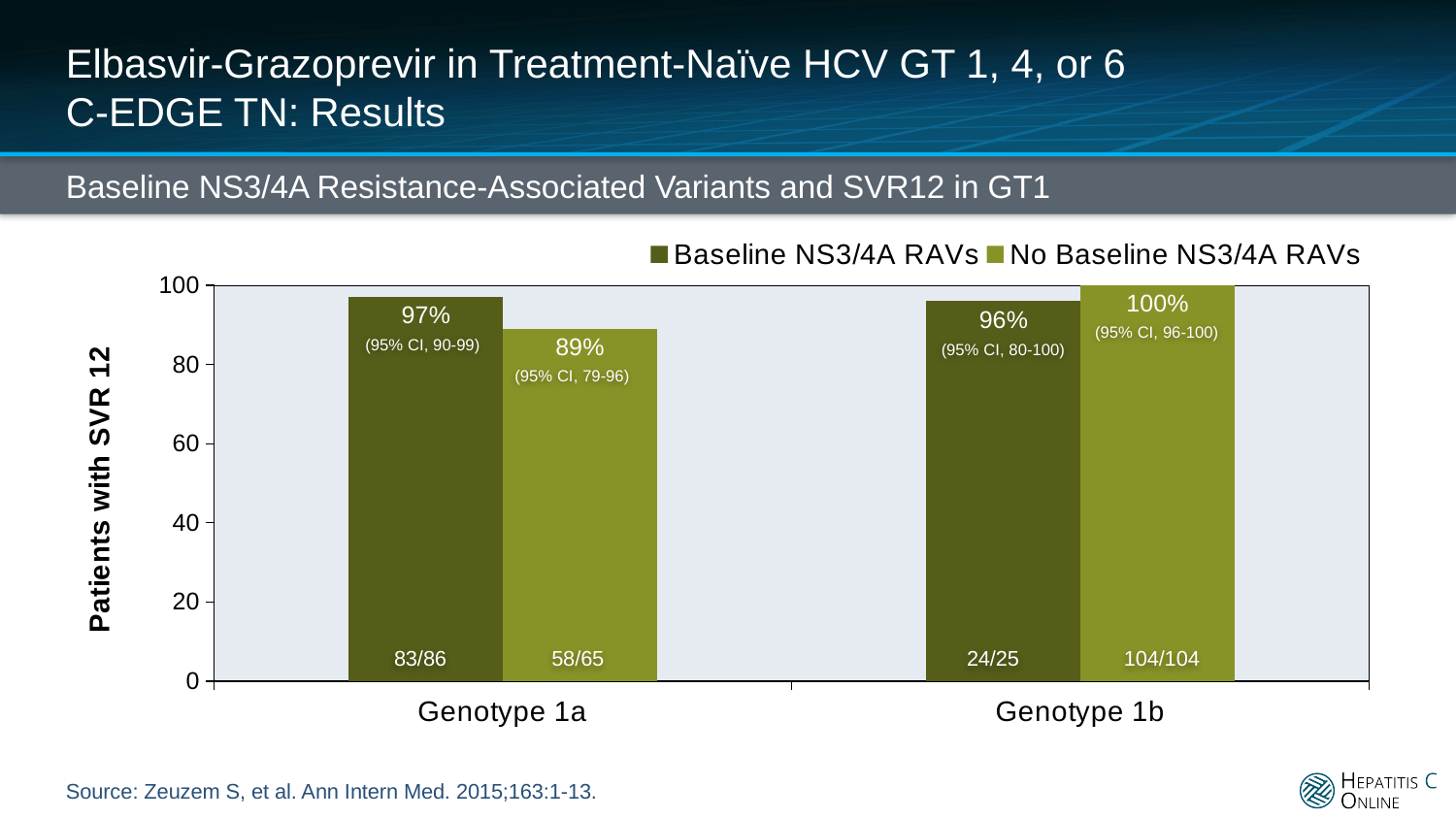
What is the 95% confidence interval shown for the Genotype 1a No Baseline NS3/4A RAVs group? 79-96 What is the SVR12 rate for patients with No Baseline NS3/4A RAVs in Genotype 1b? 100% What is the SVR12 rate for patients with Baseline NS3/4A RAVs in Genotype 1b? 96% What is the SVR12 rate for patients with No Baseline NS3/4A RAVs in Genotype 1a? 89% What is the SVR12 rate for patients with Baseline NS3/4A RAVs in Genotype 1a? 97% What kind of chart is shown on the slide? Bar chart Which group has the highest SVR12 rate on the chart? Genotype 1b, No Baseline NS3/4A RAVs Which group has the lowest SVR12 rate on the chart? Genotype 1a, No Baseline NS3/4A RAVs What is the difference in SVR12 rate between the Baseline NS3/4A RAVs and No Baseline NS3/4A RAVs groups in Genotype 1a? 8% How many patients achieved SVR12 out of the total in the Genotype 1b No Baseline NS3/4A RAVs group? 104/104 In Genotype 1b, which group has the higher SVR12 rate: Baseline NS3/4A RAVs or No Baseline NS3/4A RAVs? No Baseline NS3/4A RAVs How many series does the legend list? 2